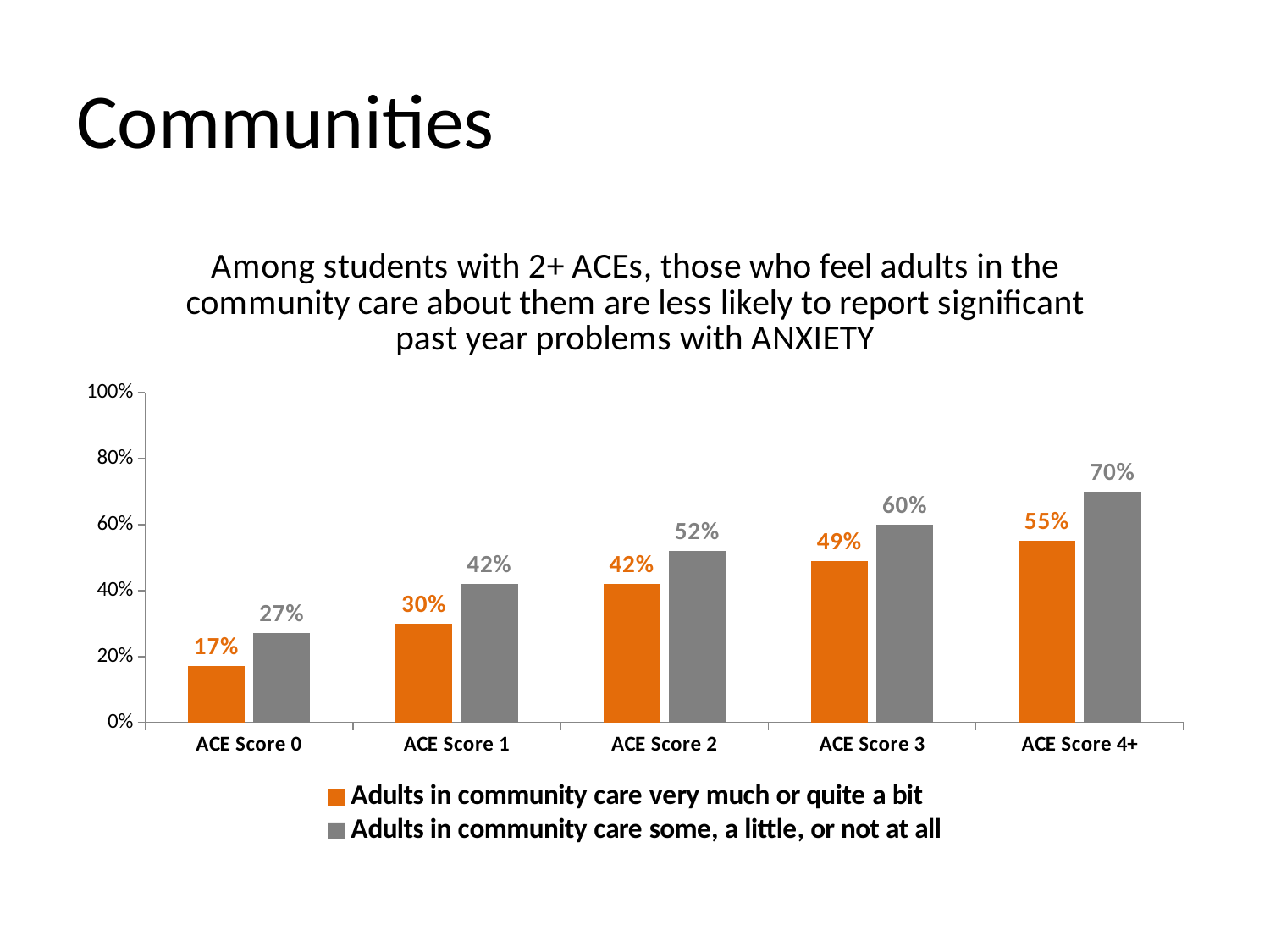
What is the difference between the two series for ACE Score 3? 11% Which ACE score category has the lowest value in the 'Adults in community care very much or quite a bit' series? ACE Score 0 Do the values in the 'Adults in community care very much or quite a bit' series rise or fall as the ACE score increases? Rise What is the value for ACE Score 2 in the 'Adults in community care very much or quite a bit' series? 42% What colour are the bars for the 'Adults in community care very much or quite a bit' series? Orange For ACE Score 1, which series has the larger value? Adults in community care some, a little, or not at all What kind of chart is shown on the slide? Bar chart How many ACE score categories are shown on the x axis? 5 What is the value for ACE Score 0 in the 'Adults in community care very much or quite a bit' series? 17% How many series does the legend list? 2 Which ACE score category has the highest value in the 'Adults in community care some, a little, or not at all' series? ACE Score 4+ What is the value for ACE Score 4+ in the 'Adults in community care some, a little, or not at all' series? 70%